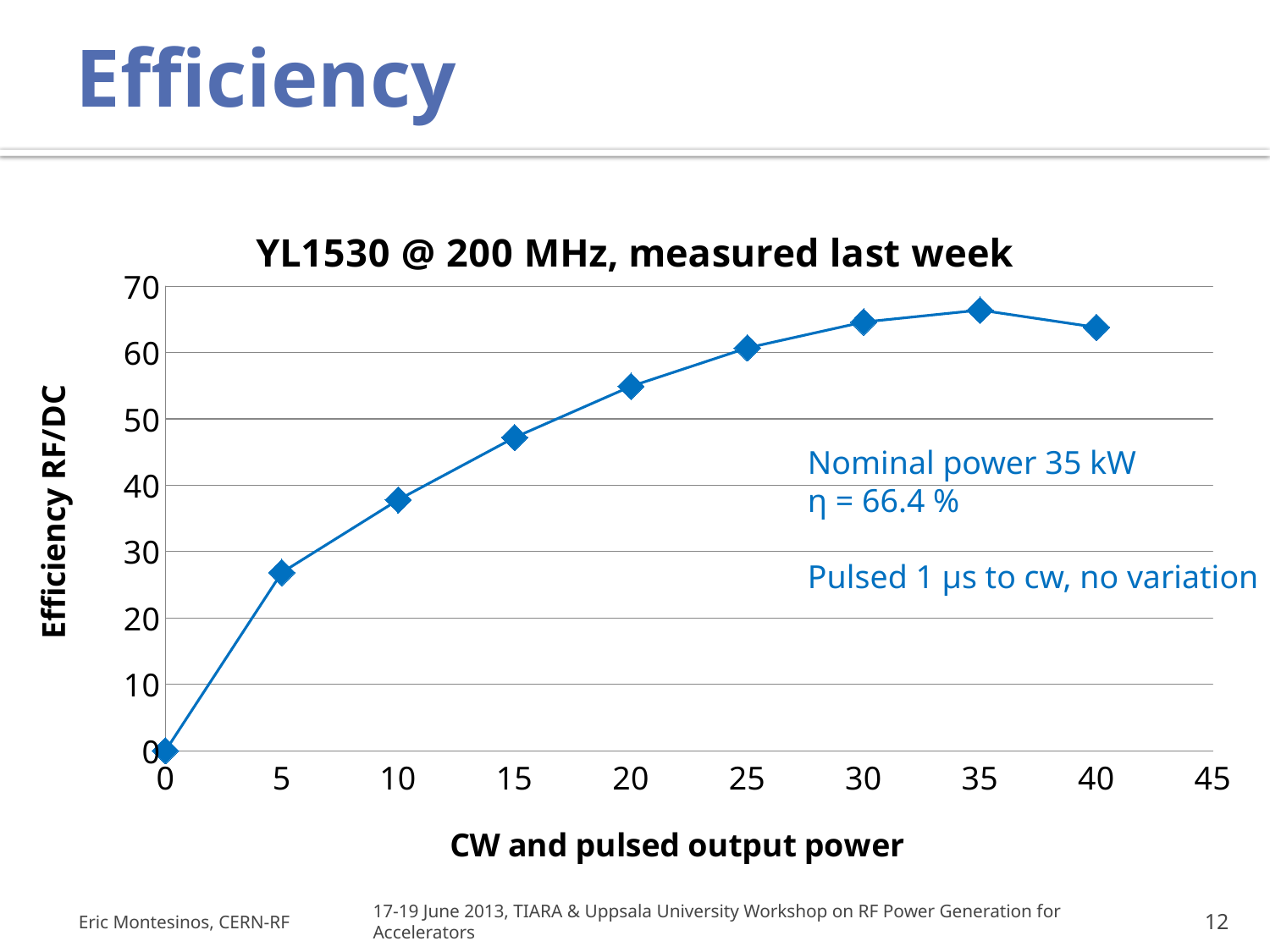
What is the title of the chart? YL1530 @ 200 MHz, measured last week At which output power is the efficiency highest? 35 Is the efficiency at an output power of 5 greater or less than 30? less Which has the higher efficiency: an output power of 15 or an output power of 25? 25 Is the efficiency at an output power of 10 greater or less than 40? less According to the annotation, what is the efficiency η at the nominal power of 35 kW? 66.4 % What is the efficiency value at an output power of 0? 0 How many data points are plotted on the chart? 9 At which output power is the efficiency lowest? 0 What is the label of the vertical axis? Efficiency RF/DC What kind of chart is shown on the slide? line chart Is the efficiency at an output power of 20 greater or less than 50? greater